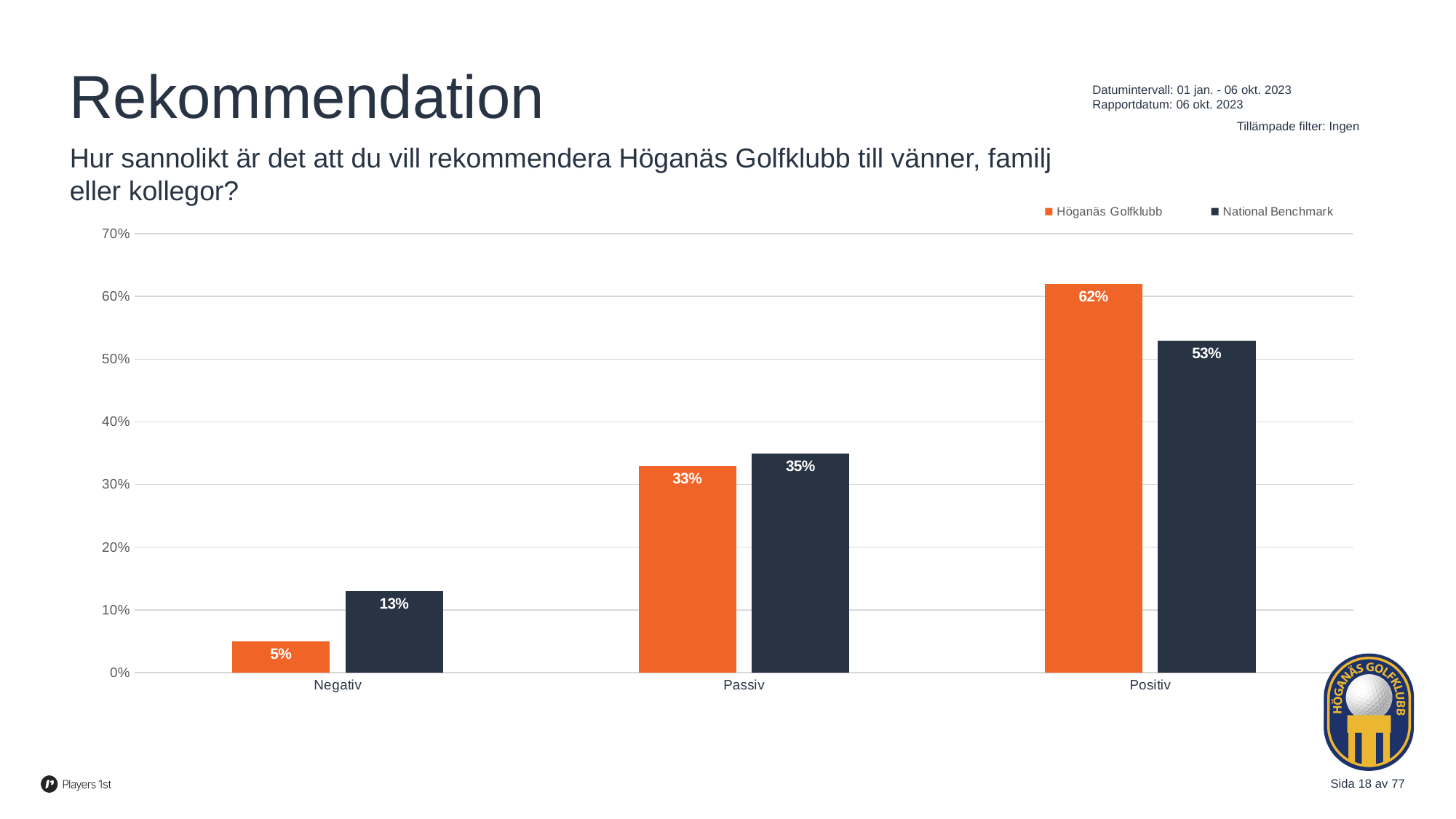
What kind of chart is shown on the slide? Bar chart What is the difference between Höganäs Golfklubb and National Benchmark in the Positiv category? 9% Which category has the highest value for Höganäs Golfklubb? Positiv What is the value for Höganäs Golfklubb in the Positiv category? 62% How many series does the legend list? 2 What is the value for National Benchmark in the Positiv category? 53% Is the value for National Benchmark in the Passiv category greater or less than 30%? greater What is the value for National Benchmark in the Negativ category? 13% Which category has the lowest value for National Benchmark? Negativ What is the value for Höganäs Golfklubb in the Passiv category? 33% In the Negativ category, which is larger: Höganäs Golfklubb or National Benchmark? National Benchmark How many categories are shown on the x axis? 3